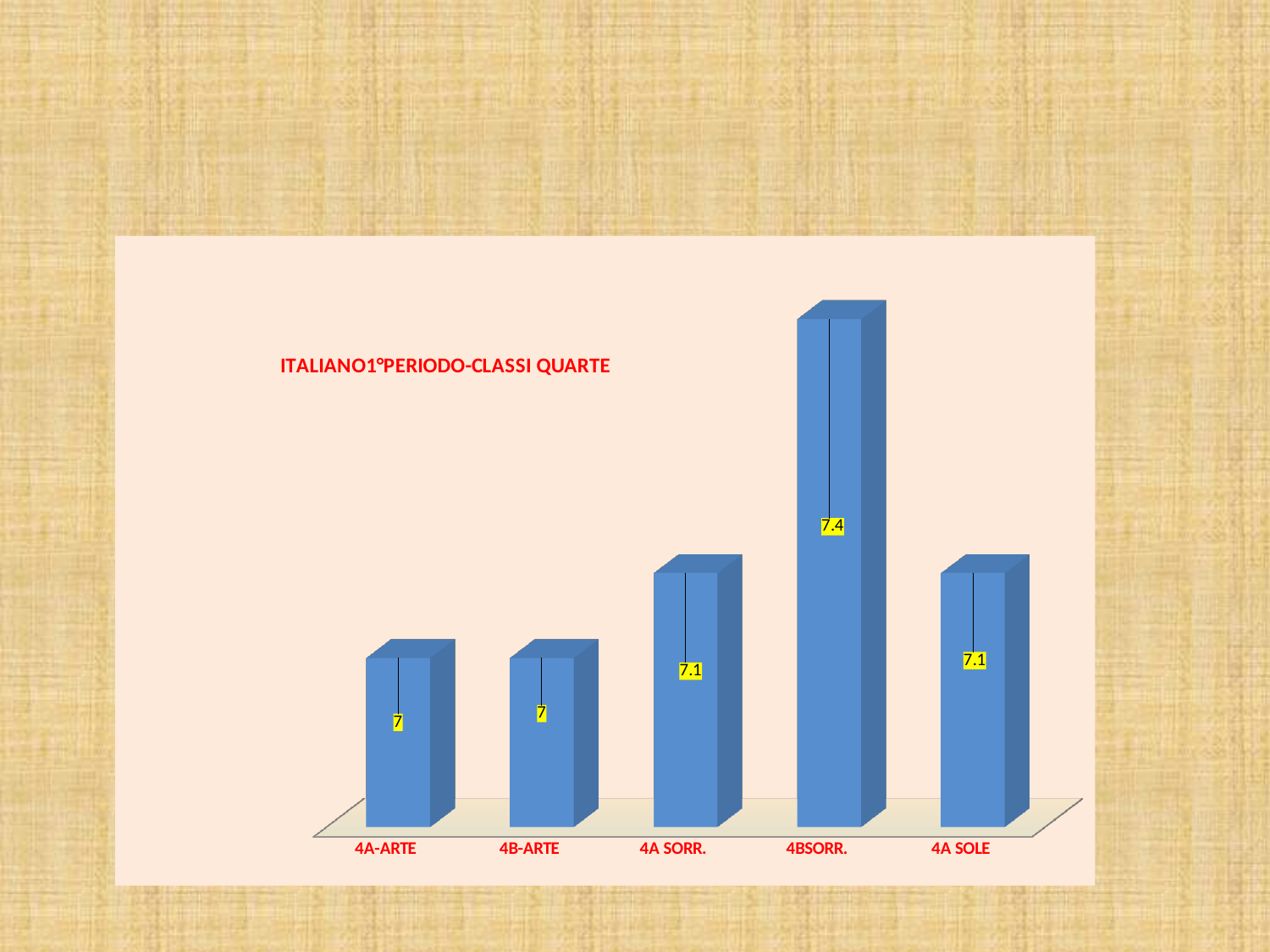
What is the value for 4A SOLE? 7.1 What is the title of the chart? ITALIANO1°PERIODO-CLASSI QUARTE What is the value for 4A-ARTE? 7 What is the difference between the values for 4BSORR. and 4A SORR.? 0.3 What is the value for 4B-ARTE? 7 What is the difference between the values for 4A SOLE and 4A-ARTE? 0.1 What kind of chart is shown on the slide? bar chart What is the value for 4BSORR.? 7.4 Which category has the highest value? 4BSORR. Which is larger, the value for 4BSORR. or the value for 4A SOLE? 4BSORR. How many categories are shown in the chart? 5 What is the value for 4A SORR.? 7.1